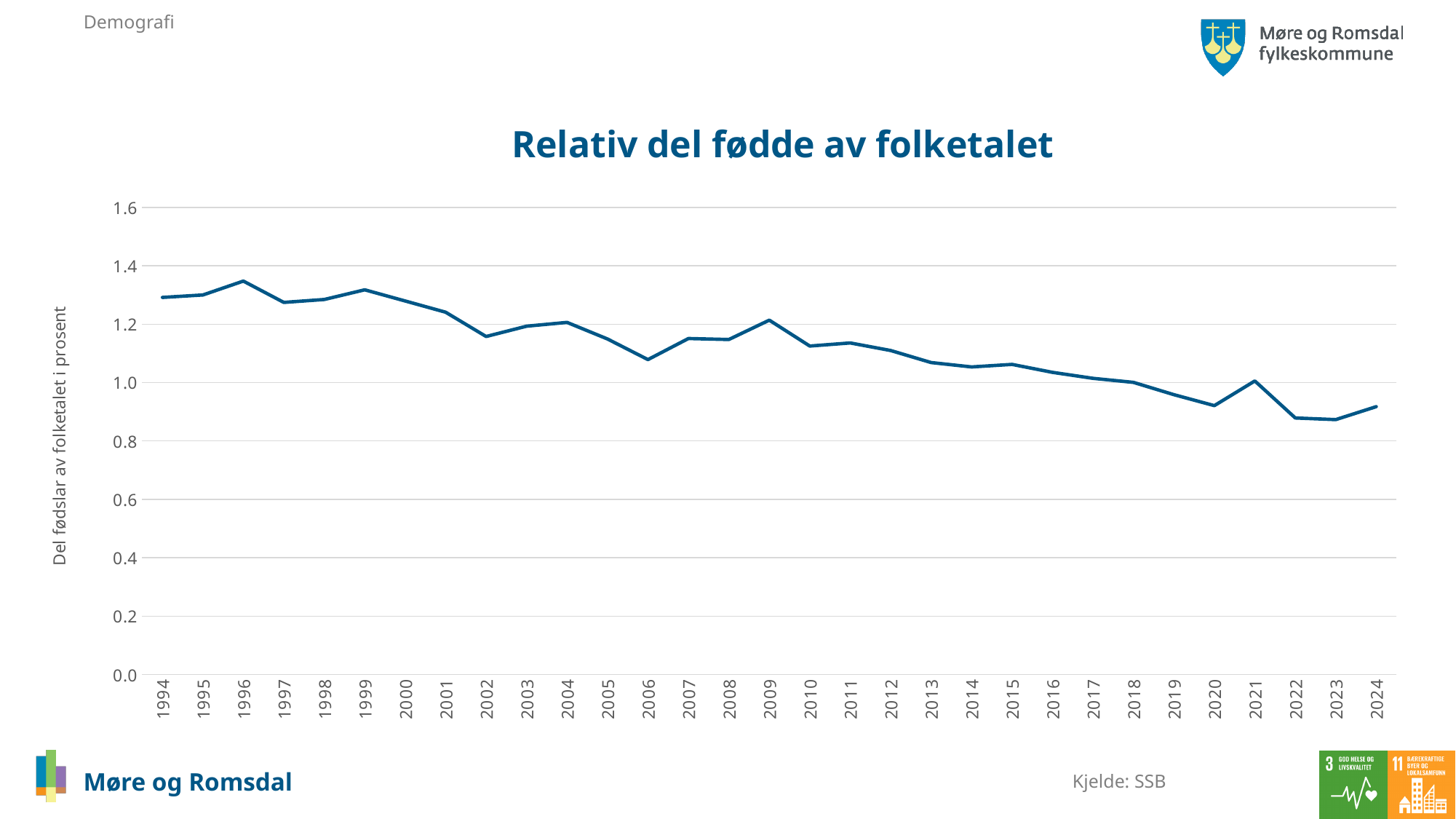
In which year does the line reach its highest value? 1996 Which year has the larger value, 2006 or 2009? 2009 Which year has the larger value, 1996 or 2002? 1996 Overall, do the values rise or fall from 1994 to 2024? fall What kind of chart is shown on the slide? line chart What is the label on the vertical axis of the chart? Del fødslar av folketalet i prosent Is the value for 2006 greater or less than 1.2? less How many years are plotted along the x axis of the chart? 31 Is the value for 2020 greater or less than 1.0? less Is the value for 1994 greater or less than 1.2? greater What is the title of the chart? Relativ del fødde av folketalet